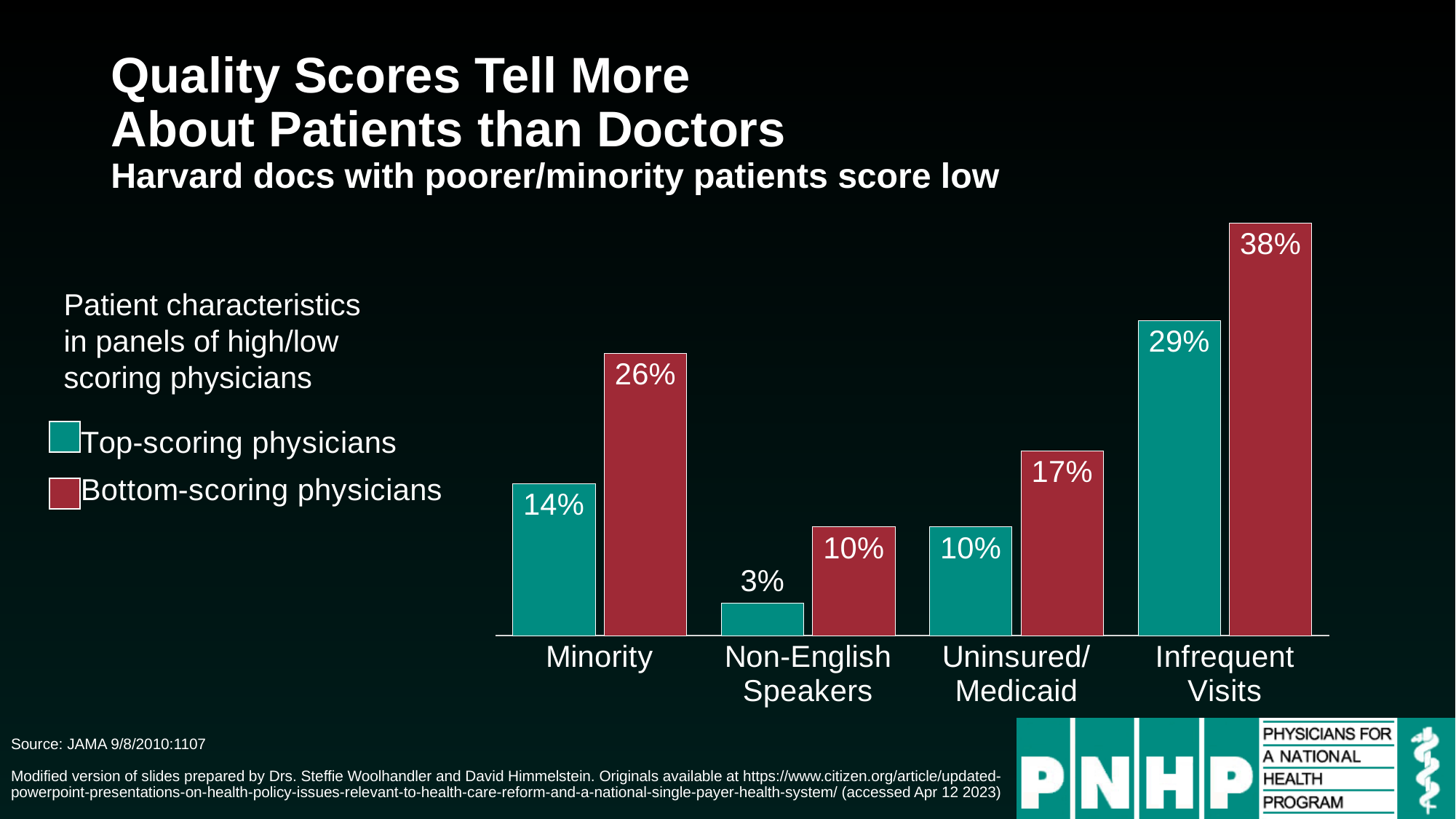
What is the difference between bottom-scoring and top-scoring physicians for Infrequent Visits? 9% For Uninsured/Medicaid, which group has the larger value: top-scoring or bottom-scoring physicians? Bottom-scoring physicians What percentage of patients in panels of top-scoring physicians are Minority? 14% What is the difference between bottom-scoring and top-scoring physicians for Minority patients? 12% What percentage of patients in panels of bottom-scoring physicians are Non-English Speakers? 10% How many series does the legend list? 2 What is the value for Uninsured/Medicaid among top-scoring physicians? 10% What kind of chart is shown on the slide? Bar chart What is the value for Infrequent Visits among bottom-scoring physicians? 38% Which patient characteristic has the lowest value for top-scoring physicians? Non-English Speakers Which patient characteristic has the highest value for bottom-scoring physicians? Infrequent Visits How many patient characteristic categories are shown on the x axis? 4